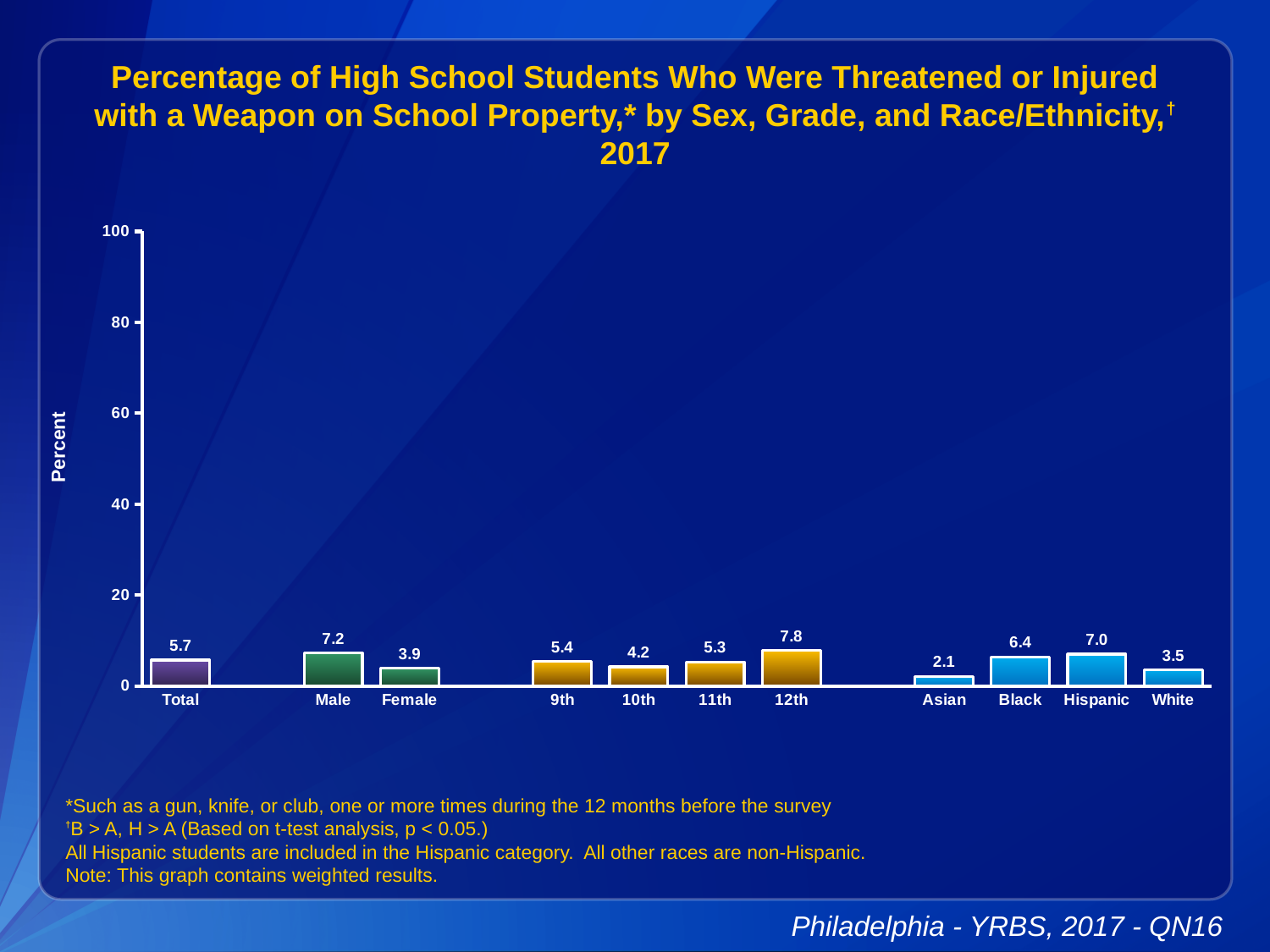
What is the value for 12th grade? 7.8 What is the label of the y axis? Percent What is the value for Asian? 2.1 Which is larger, the value for Black or the value for Hispanic? Hispanic What is the difference between the Male and Female values? 3.3 How many categories are shown on the x axis? 11 Which category has the highest value? 12th What is the value for Total? 5.7 What is the value for Male? 7.2 Which category has the lowest value? Asian What kind of chart is this? bar chart Is the value for 10th grade greater or less than 20? less